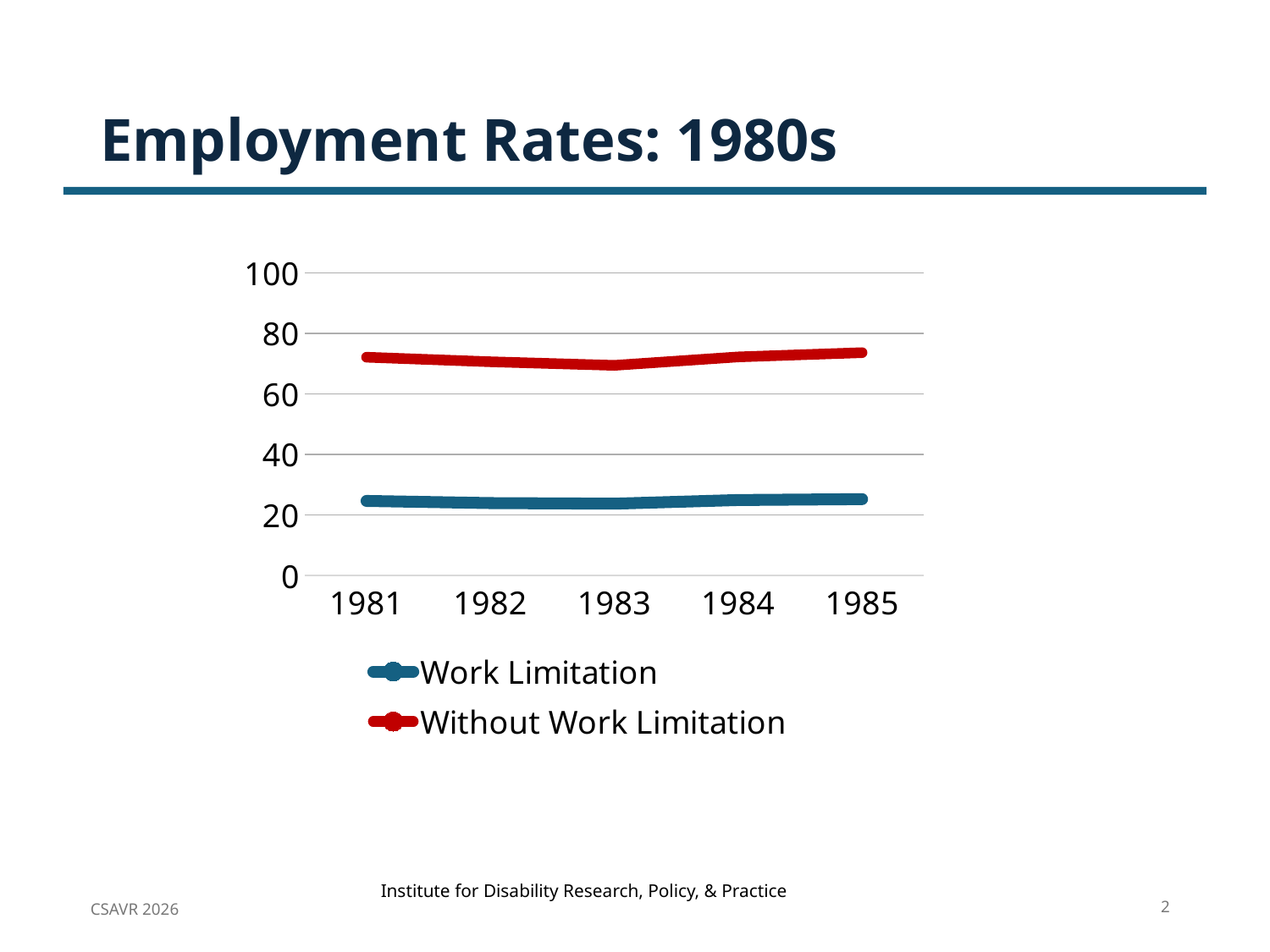
Which series is drawn in red? Without Work Limitation What is the first year shown on the x axis? 1981 What is the title of the slide containing the chart? Employment Rates: 1980s Which series has the higher employment rate in 1985, Work Limitation or Without Work Limitation? Without Work Limitation Is the value for Work Limitation in 1981 greater or less than 20? greater Is the value for Without Work Limitation in 1985 greater or less than 60? greater Is the value for Work Limitation in 1983 greater or less than 40? less How many series does the legend list? 2 What kind of chart is shown on the slide? line chart Which series has the lower employment rate in 1981, Work Limitation or Without Work Limitation? Work Limitation How many years are plotted along the x axis? 5